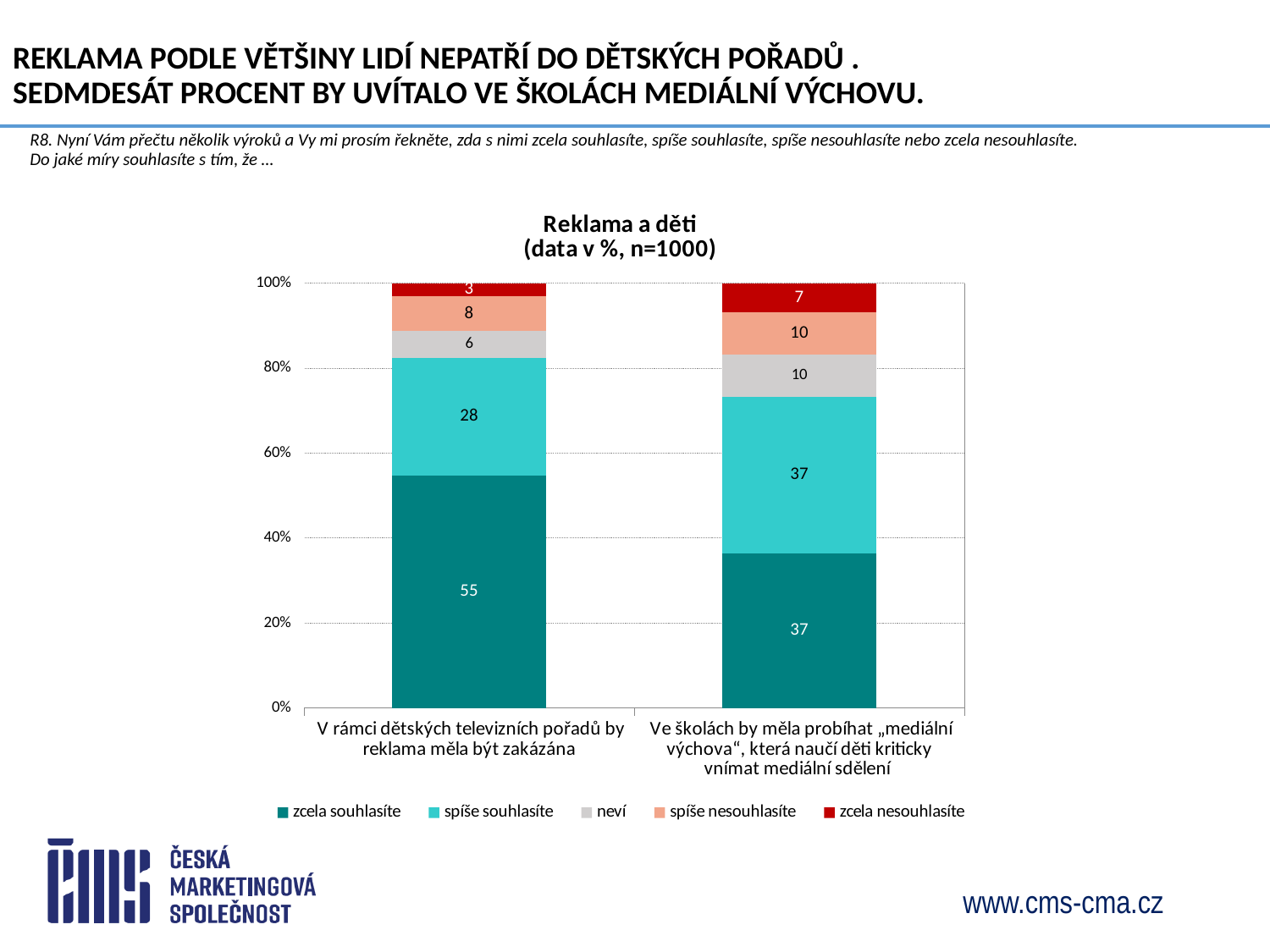
What is the title of the chart? Reklama a děti (data v %, n=1000) What type of chart is shown on the slide? stacked bar chart What is the value for "zcela souhlasíte" for the statement "V rámci dětských televizních pořadů by reklama měla být zakázána"? 55 What is the value for "zcela nesouhlasíte" for the statement "V rámci dětských televizních pořadů by reklama měla být zakázána"? 3 How many series does the legend list? 5 How many statements (categories) are shown on the x axis? 2 What is the value for "spíše souhlasíte" for the statement "Ve školách by měla probíhat „mediální výchova“, která naučí děti kriticky vnímat mediální sdělení"? 37 Which series has the lowest value for the statement "V rámci dětských televizních pořadů by reklama měla být zakázána"? zcela nesouhlasíte What is the value for "neví" for the statement "Ve školách by měla probíhat „mediální výchova“, která naučí děti kriticky vnímat mediální sdělení"? 10 What is the difference between the "zcela souhlasíte" values for the two statements? 18 Which statement has the higher "zcela nesouhlasíte" value? Ve školách by měla probíhat „mediální výchova“, která naučí děti kriticky vnímat mediální sdělení What is the total of the stacked bar for "V rámci dětských televizních pořadů by reklama měla být zakázána"? 100